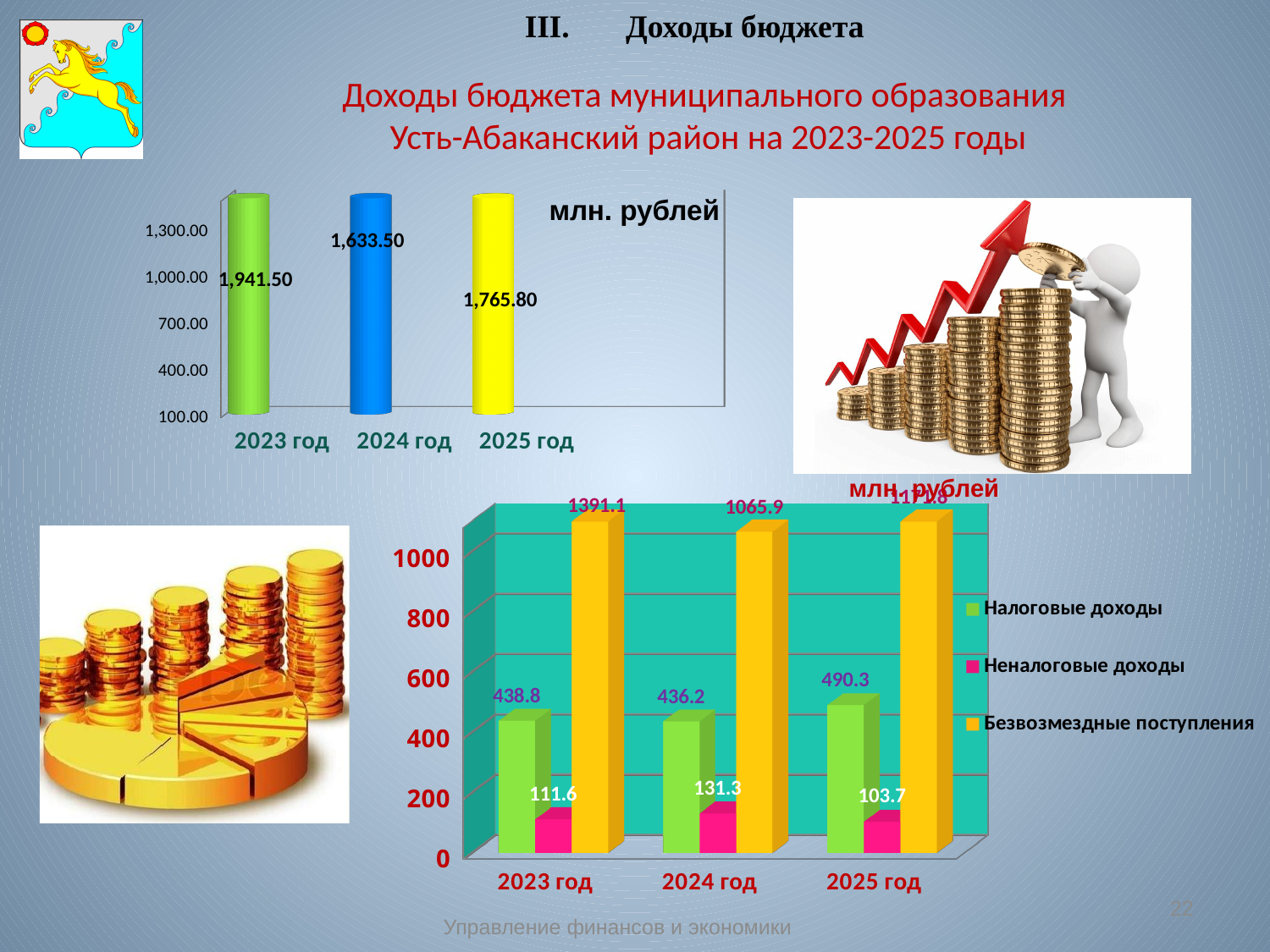
In the top chart, what is the difference between the values for 2023 год and 2025 год? 175.70 In the top chart, what is the value for 2023 год? 1,941.50 In the top chart, what is the value for 2024 год? 1,633.50 In the bottom chart, which year has the lowest value of Неналоговые доходы? 2025 год In the bottom chart, what is the value of Безвозмездные поступления for 2023 год? 1391.1 What kind of chart is the top chart? bar chart In the bottom chart, how many series does the legend list? 3 In the top chart, which year has the lowest value? 2024 год In the bottom chart, what is the value of Налоговые доходы for 2025 год? 490.3 In the bottom chart, is the value of Безвозмездные поступления for 2025 год greater or less than 1000? greater In the bottom chart, what is the value of Неналоговые доходы for 2024 год? 131.3 In the top chart, how many years are shown? 3